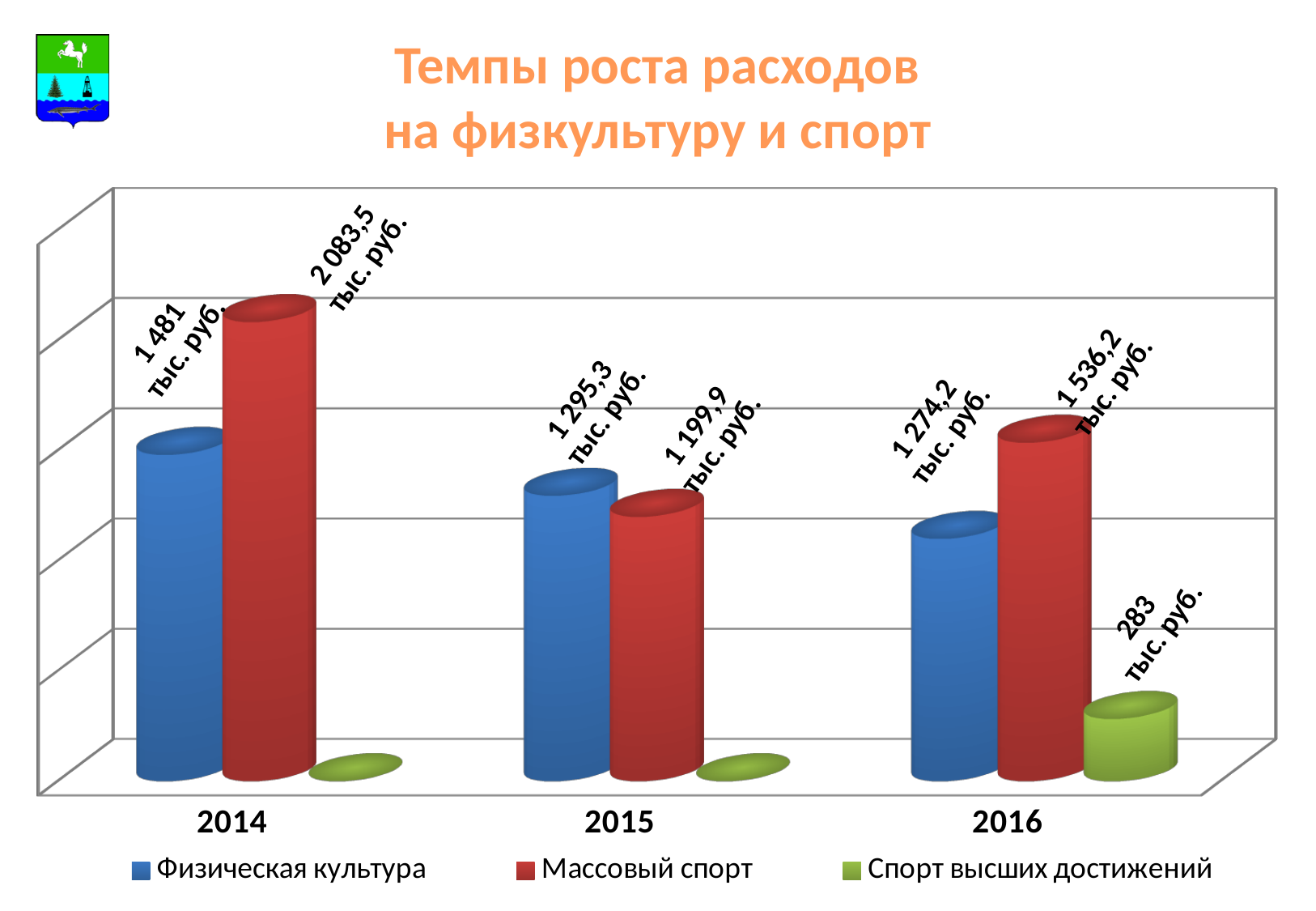
What is the value for Массовый спорт in 2014? 2 083,5 тыс. руб. In 2015, which is larger: Физическая культура or Массовый спорт? Физическая культура What is the value for Физическая культура in 2015? 1 295,3 тыс. руб. In which year is the value for Массовый спорт the lowest? 2015 What is the difference between Массовый спорт and Физическая культура in 2014? 602,5 тыс. руб. What is the value for Спорт высших достижений in 2016? 283 тыс. руб. What kind of chart is shown on the slide? Bar chart How many series does the legend list? 3 What is the value for Массовый спорт in 2016? 1 536,2 тыс. руб. How many years are shown on the x axis? 3 Does the value for Физическая культура rise or fall from 2014 to 2016? Fall In which year is the value for Массовый спорт the highest? 2014